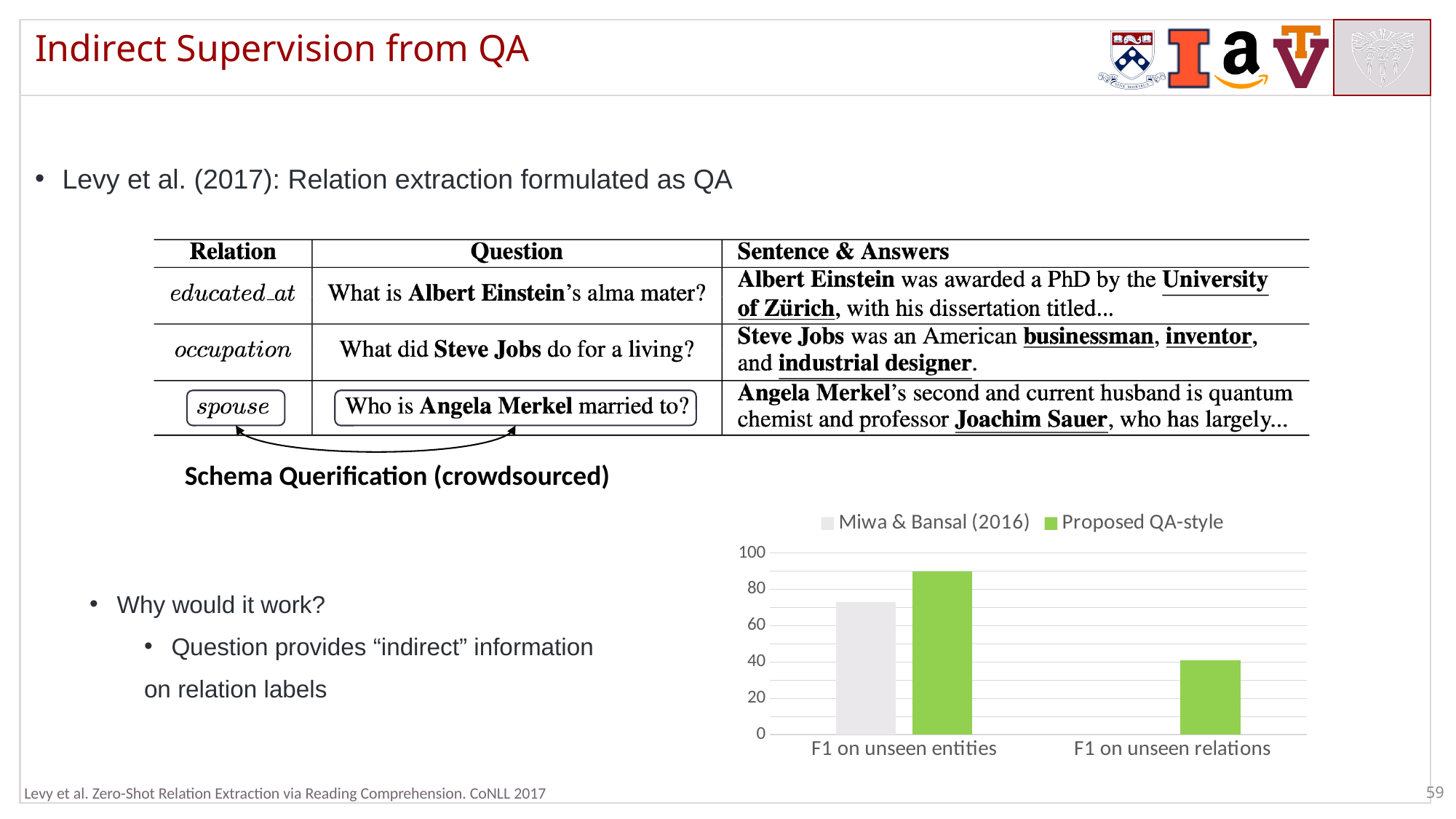
How many categories are shown on the x axis of the chart? 2 For the Proposed QA-style series, which category has the larger value: F1 on unseen entities or F1 on unseen relations? F1 on unseen entities How many series does the chart's legend list? 2 What kind of chart is shown on the slide? bar chart Which series is shown in green in the chart? Proposed QA-style Is the value for Miwa & Bansal (2016) on F1 on unseen entities greater or less than 80? less What is the highest value shown on the chart's y axis? 100 For F1 on unseen entities, which series has the larger value: Miwa & Bansal (2016) or Proposed QA-style? Proposed QA-style Is the value for Miwa & Bansal (2016) on F1 on unseen entities greater or less than 60? greater Which series has the tallest bar in the chart? Proposed QA-style Is the value for Proposed QA-style on F1 on unseen relations greater or less than 60? less